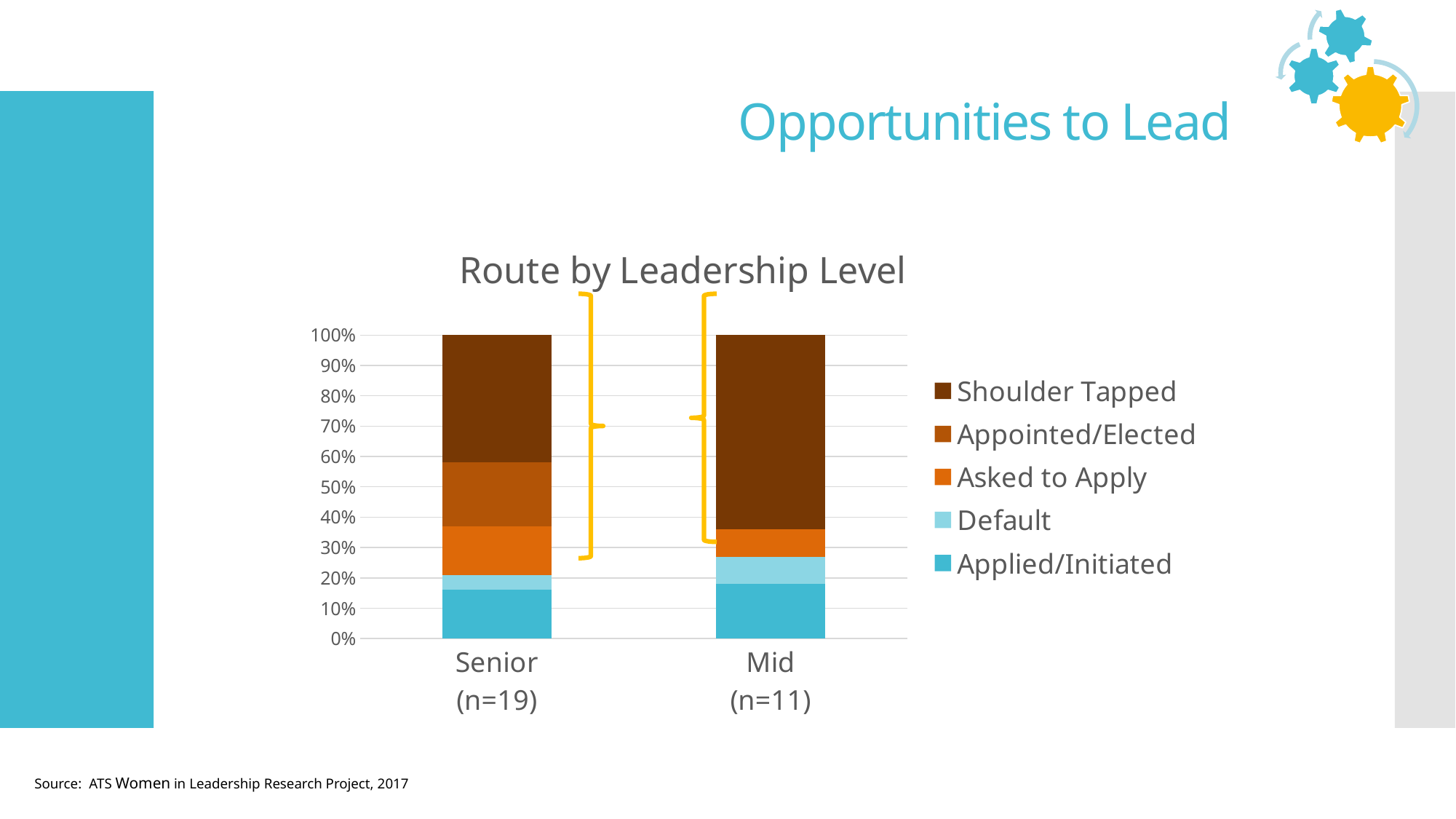
What is the sample size shown for the Mid category? n=11 What kind of chart is shown on the slide? Stacked bar chart Which route makes up the largest share of the Senior bar? Shoulder Tapped How many leadership levels (bars) are shown in the chart? 2 What is the sample size shown for the Senior category? n=19 Which leadership level has the larger Shoulder Tapped share, Senior or Mid? Mid Is the Shoulder Tapped share for Senior greater or less than 50%? less Is the Shoulder Tapped share for Mid greater or less than 50%? greater What is the title of the chart? Route by Leadership Level Which leadership level has the larger Appointed/Elected share, Senior or Mid? Senior Which route makes up the largest share of the Mid bar? Shoulder Tapped How many series does the chart legend list? 5